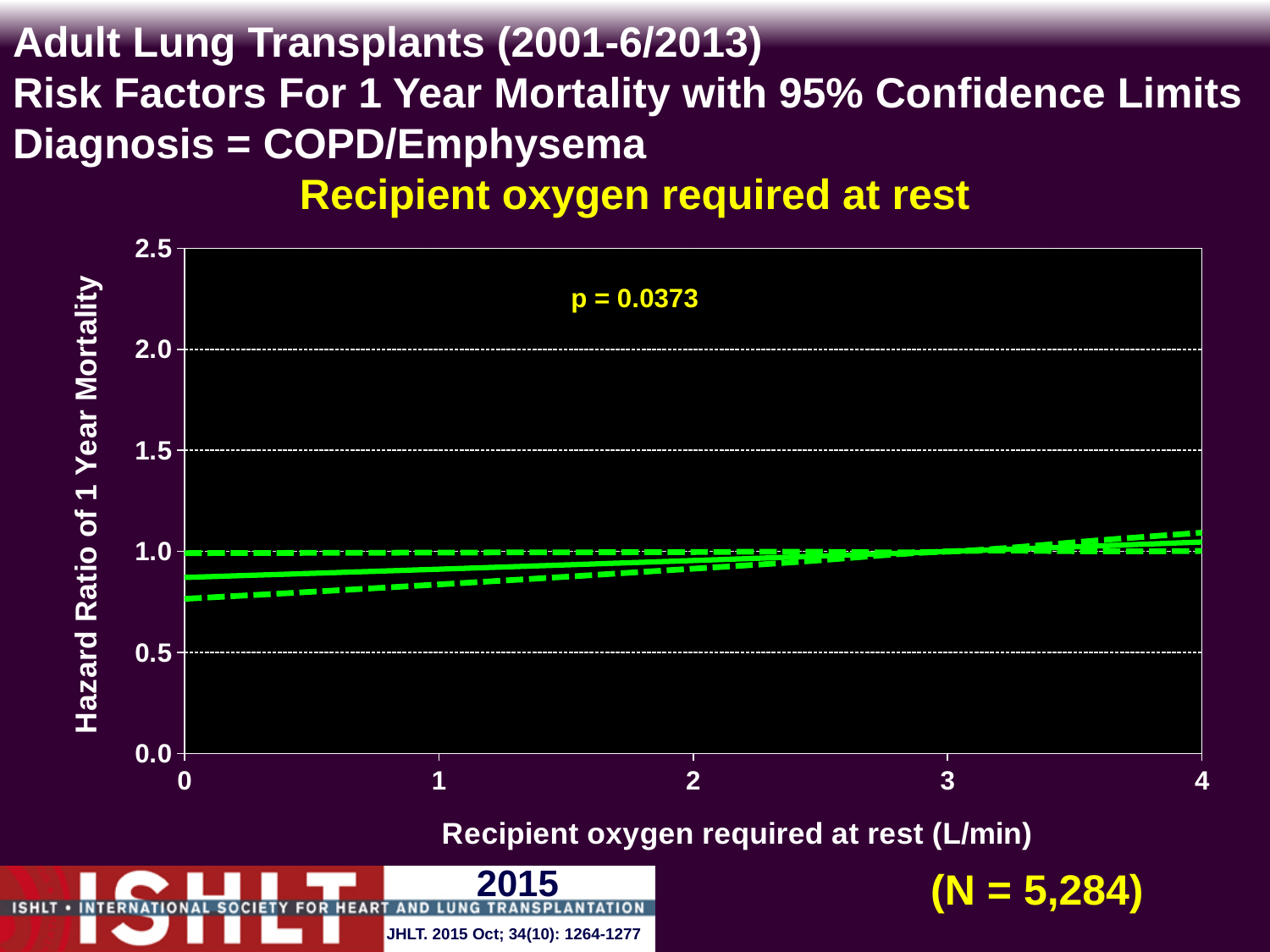
Is the hazard ratio at 2 L/min of recipient oxygen required at rest greater or less than 0.5? greater What is the highest value shown on the y axis of the chart? 2.5 Is the hazard ratio at 4 L/min of recipient oxygen required at rest greater or less than 1.5? less How many lines are plotted on the chart (the estimate plus its confidence limits)? 3 Is the hazard ratio at 0 L/min larger or smaller than the hazard ratio at 4 L/min? smaller Is the hazard ratio at 0 L/min of recipient oxygen required at rest greater or less than 1.0? less What kind of chart is shown on the slide? line chart What p-value is printed on the chart? p = 0.0373 Does the hazard ratio of 1 year mortality rise or fall as recipient oxygen required at rest increases from 0 to 4 L/min? rise